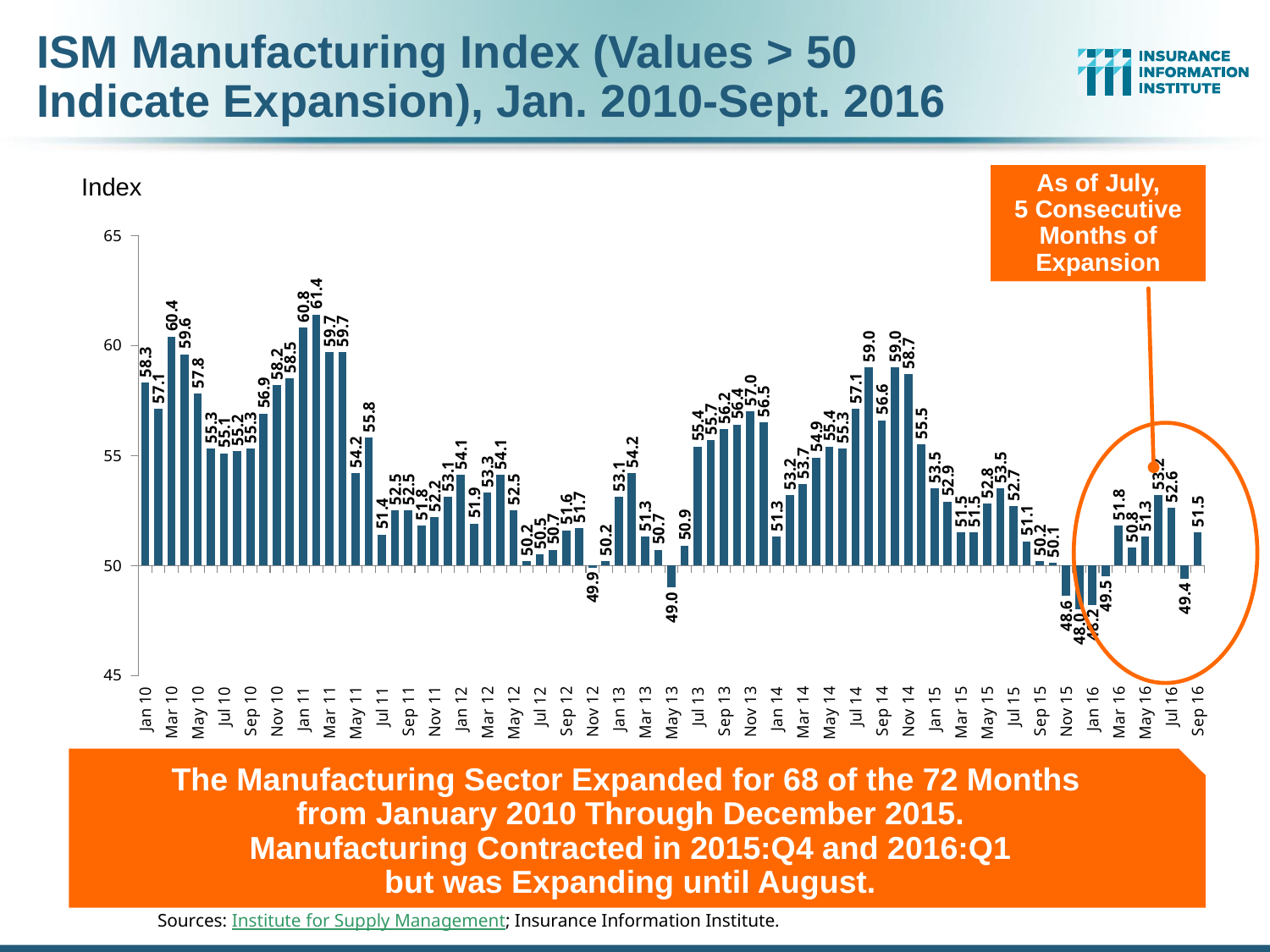
Which is larger, the index value for Jan 10 or the value for Sep 16? Jan 10 What is the ISM Manufacturing Index value for Sep 16? 51.5 What kind of chart is shown on the slide? bar chart What label is shown on the vertical axis of the chart? Index What is the lowest index value shown on the chart? 48.0 What is the ISM Manufacturing Index value for May 13? 49.0 What is the difference between the index value for Jan 10 and the value for Sep 16? 6.8 Do the index values rise or fall from Jul 13 to Nov 13? rise What is the ISM Manufacturing Index value for Mar 10? 60.4 Is the index value for Jan 11 greater or less than 60? greater What is the highest index value shown on the chart? 61.4 What is the ISM Manufacturing Index value for Jan 10? 58.3